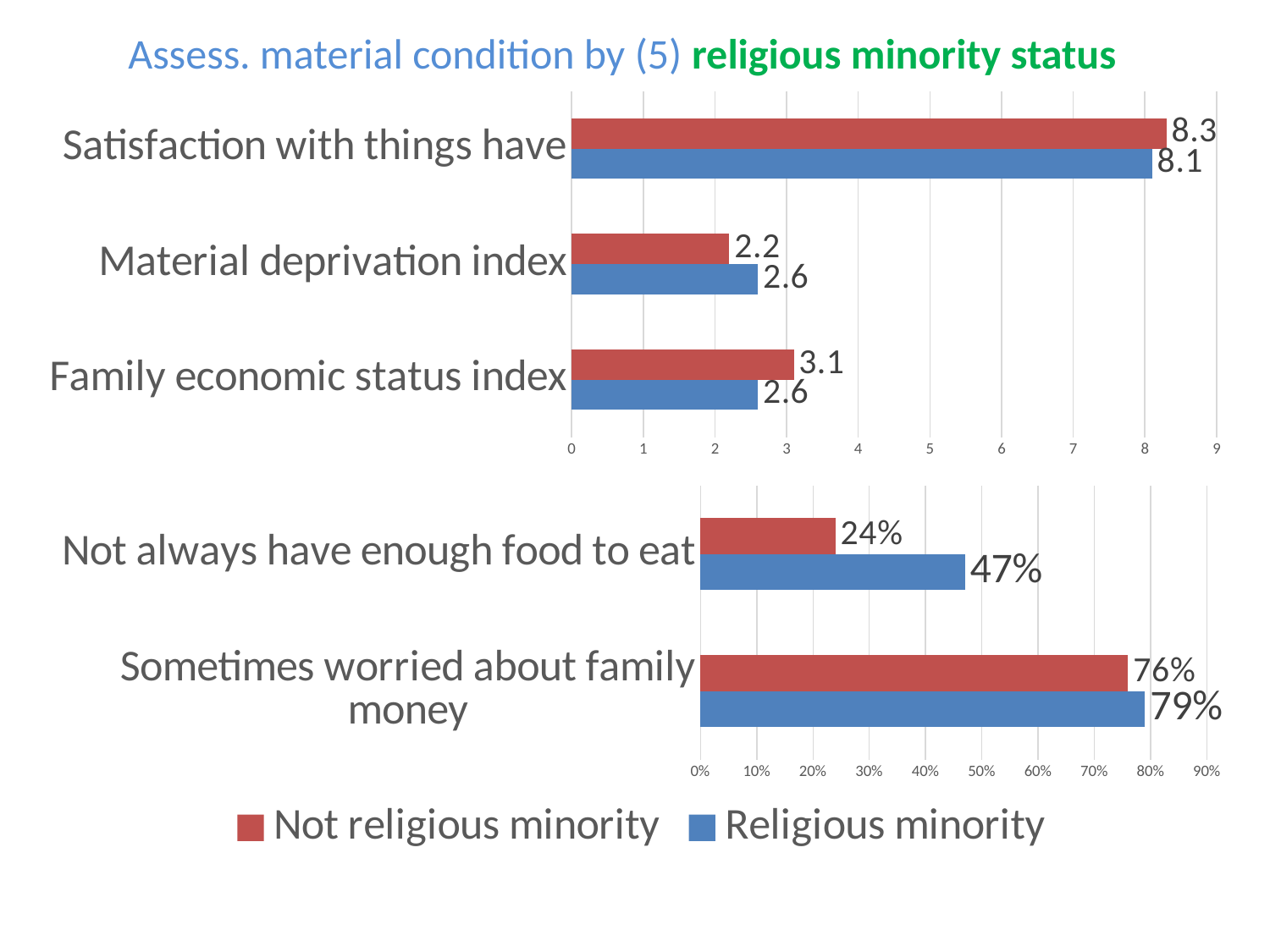
How many categories are shown in the bottom chart? 2 What type of chart is the top chart? Bar chart In the top chart, what is the Material deprivation index for the Religious minority group? 2.6 How many series does the legend list? 2 In the bottom chart, what is the difference between the Religious minority and Not religious minority values for Not always have enough food to eat? 23 percentage points In the top chart, which group has the higher Material deprivation index? Religious minority In the bottom chart, what percentage of the Religious minority group does not always have enough food to eat? 47% In the bottom chart, what percentage of the Not religious minority group is sometimes worried about family money? 76% In the bottom chart, which category has the highest value for the Religious minority group? Sometimes worried about family money In the top chart, what is the value for Satisfaction with things have for the Not religious minority group? 8.3 In the top chart, what is the Family economic status index for the Not religious minority group? 3.1 In the top chart, what is the difference between the Not religious minority and Religious minority values for Family economic status index? 0.5